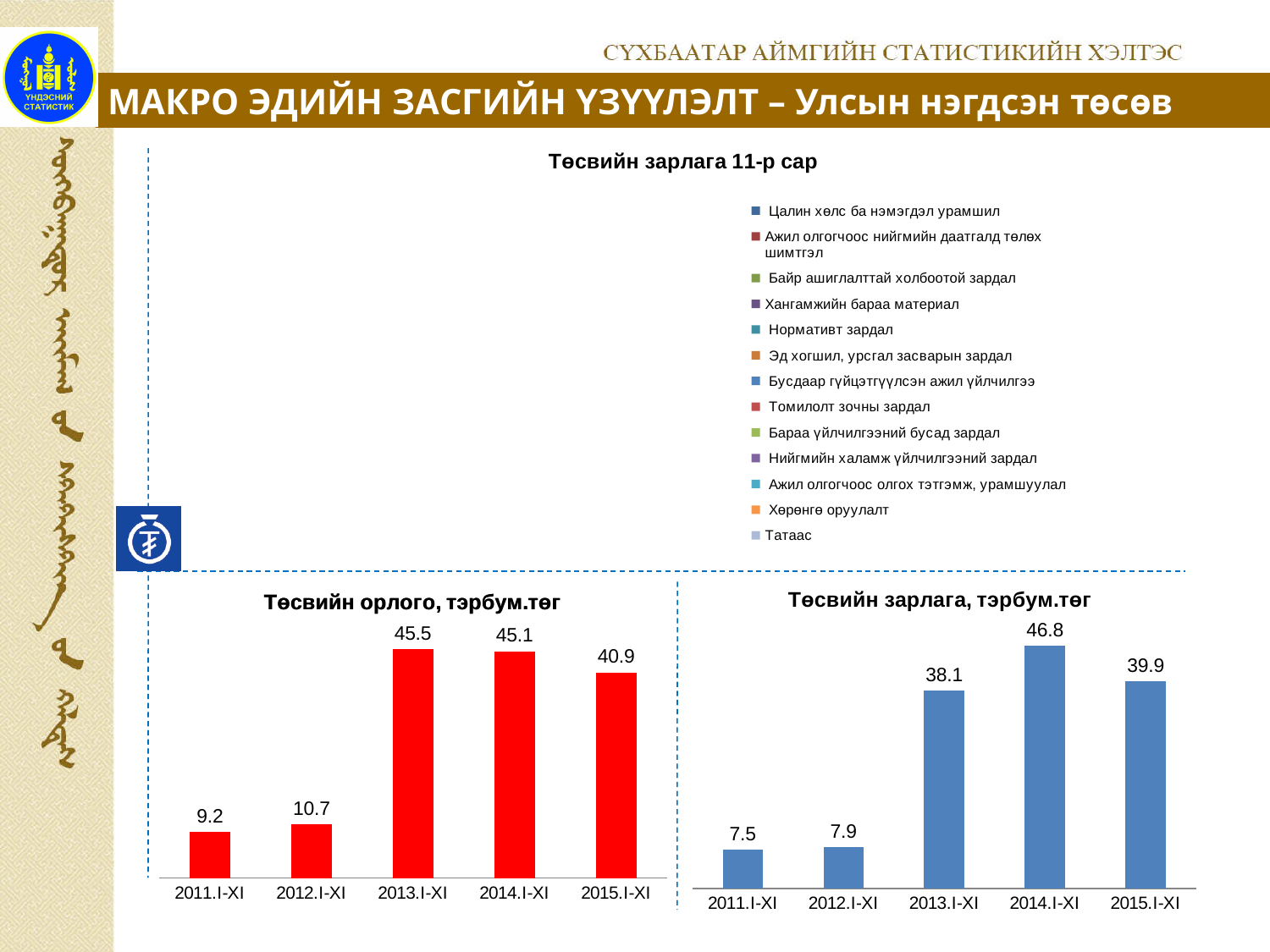
In the chart 'Төсвийн зарлага, тэрбум.төг', which category has the highest value? 2014.I-XI In the chart 'Төсвийн орлого, тэрбум.төг', how many categories are shown on the x axis? 5 In the chart 'Төсвийн орлого, тэрбум.төг', what is the value for 2012.I-XI? 10.7 In the chart 'Төсвийн зарлага, тэрбум.төг', which is larger, the value for 2015.I-XI or the value for 2013.I-XI? 2015.I-XI In the chart 'Төсвийн зарлага, тэрбум.төг', do the values rise or fall from 2011.I-XI to 2014.I-XI? rise How many entries does the legend of the chart 'Төсвийн зарлага 11-р сар' list? 13 What kind of chart is 'Төсвийн зарлага, тэрбум.төг'? bar chart In the chart 'Төсвийн зарлага, тэрбум.төг', what is the difference between the values for 2014.I-XI and 2013.I-XI? 8.7 In the chart 'Төсвийн зарлага, тэрбум.төг', what is the value for 2014.I-XI? 46.8 In the chart 'Төсвийн орлого, тэрбум.төг', what is the value for 2013.I-XI? 45.5 In the chart 'Төсвийн орлого, тэрбум.төг', which category has the lowest value? 2011.I-XI In the chart 'Төсвийн орлого, тэрбум.төг', what is the difference between the values for 2013.I-XI and 2015.I-XI? 4.6